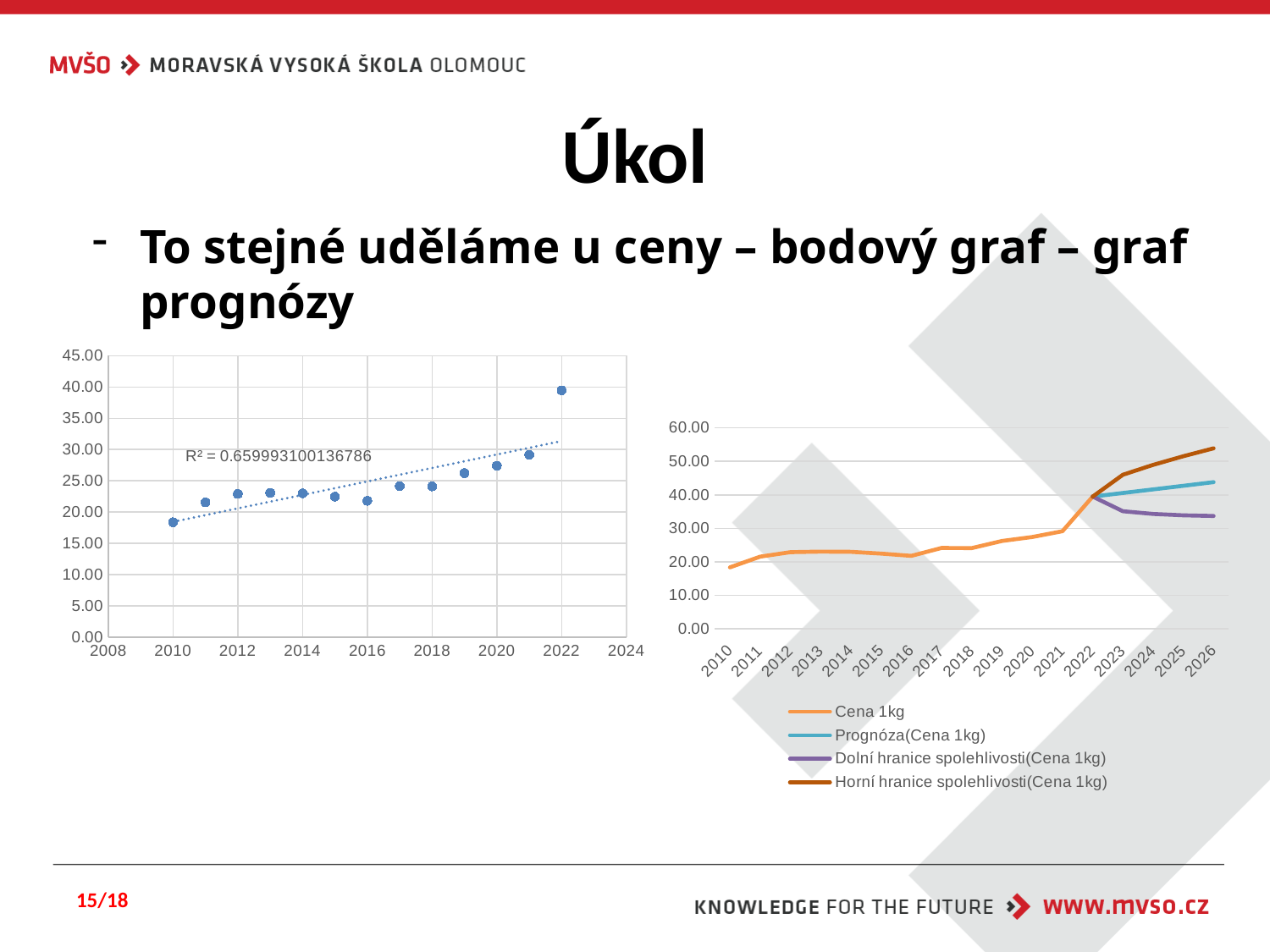
What kind of chart is the chart on the right of the slide? line chart What kind of chart is the chart on the left of the slide? scatter chart How many data points are plotted in the left scatter chart? 13 How many series does the legend of the right chart list? 4 In the left chart, which year has the highest plotted value? 2022 In the left chart, is the value for 2022 greater or less than 35.00? greater In the right chart, does the Horní hranice spolehlivosti(Cena 1kg) line rise or fall from 2022 to 2026? rise In the right chart, is the value of Dolní hranice spolehlivosti(Cena 1kg) for 2026 greater or less than 40.00? less In the left chart, what R² value is printed next to the trendline? R² = 0.659993100136786 In the left chart, which year has the lowest plotted value? 2010 In the right chart, is the value of Horní hranice spolehlivosti(Cena 1kg) for 2026 greater or less than 50.00? greater